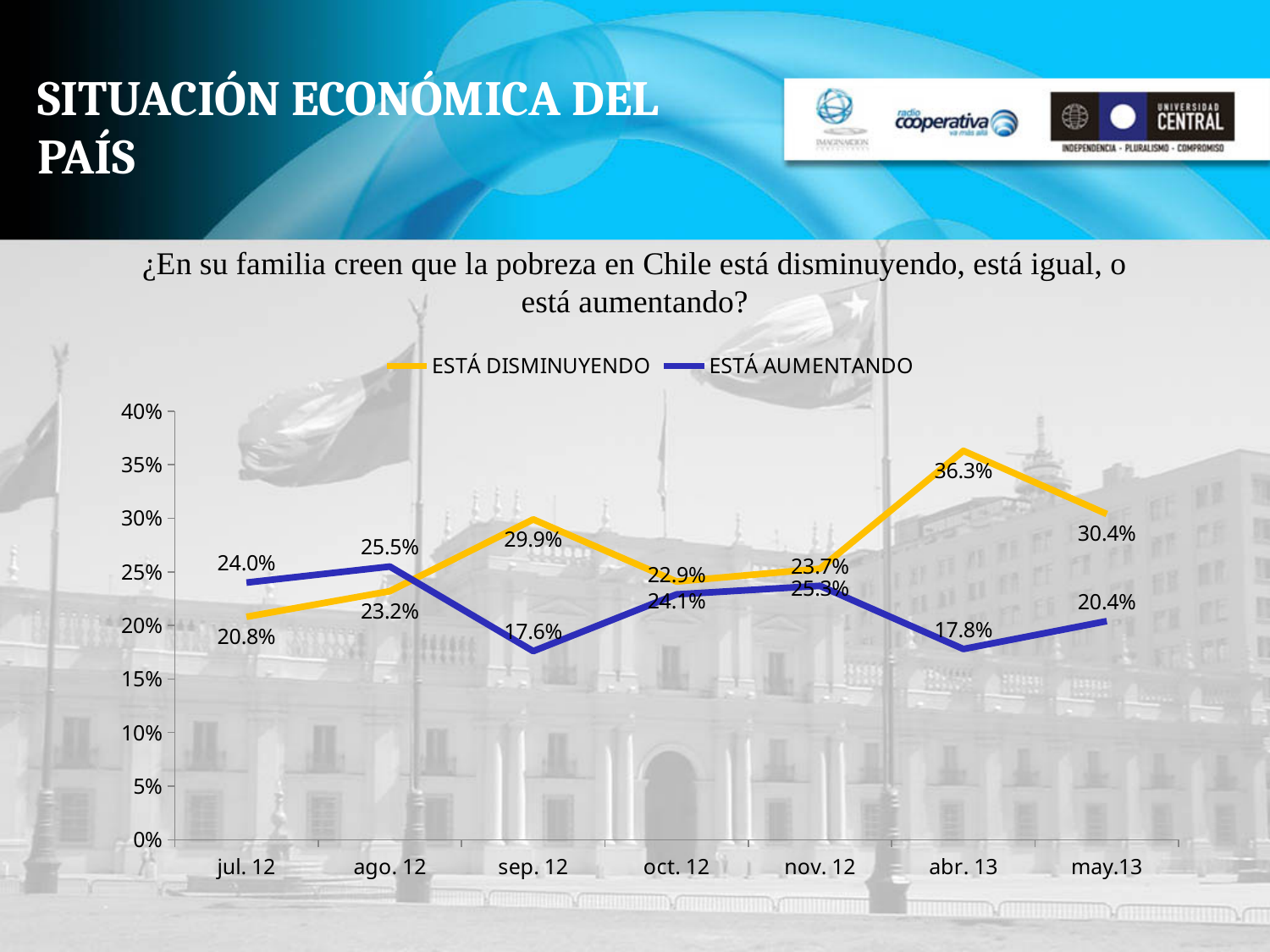
What is the value for ESTÁ AUMENTANDO in sep. 12? 17.6% How many time points are plotted along the x axis? 7 What kind of chart is shown on the slide? Line chart Does the ESTÁ DISMINUYENDO line rise or fall from abr. 13 to may.13? Fall In jul. 12, which series has the higher value, ESTÁ DISMINUYENDO or ESTÁ AUMENTANDO? ESTÁ AUMENTANDO What is the value for ESTÁ AUMENTANDO in may.13? 20.4% What is the value for ESTÁ DISMINUYENDO in jul. 12? 20.8% What is the value for ESTÁ DISMINUYENDO in abr. 13? 36.3% In which month does ESTÁ DISMINUYENDO reach its highest value? abr. 13 In which month does ESTÁ AUMENTANDO reach its lowest value? sep. 12 How many series does the legend list? 2 What is the difference between ESTÁ DISMINUYENDO and ESTÁ AUMENTANDO in abr. 13? 18.5 percentage points